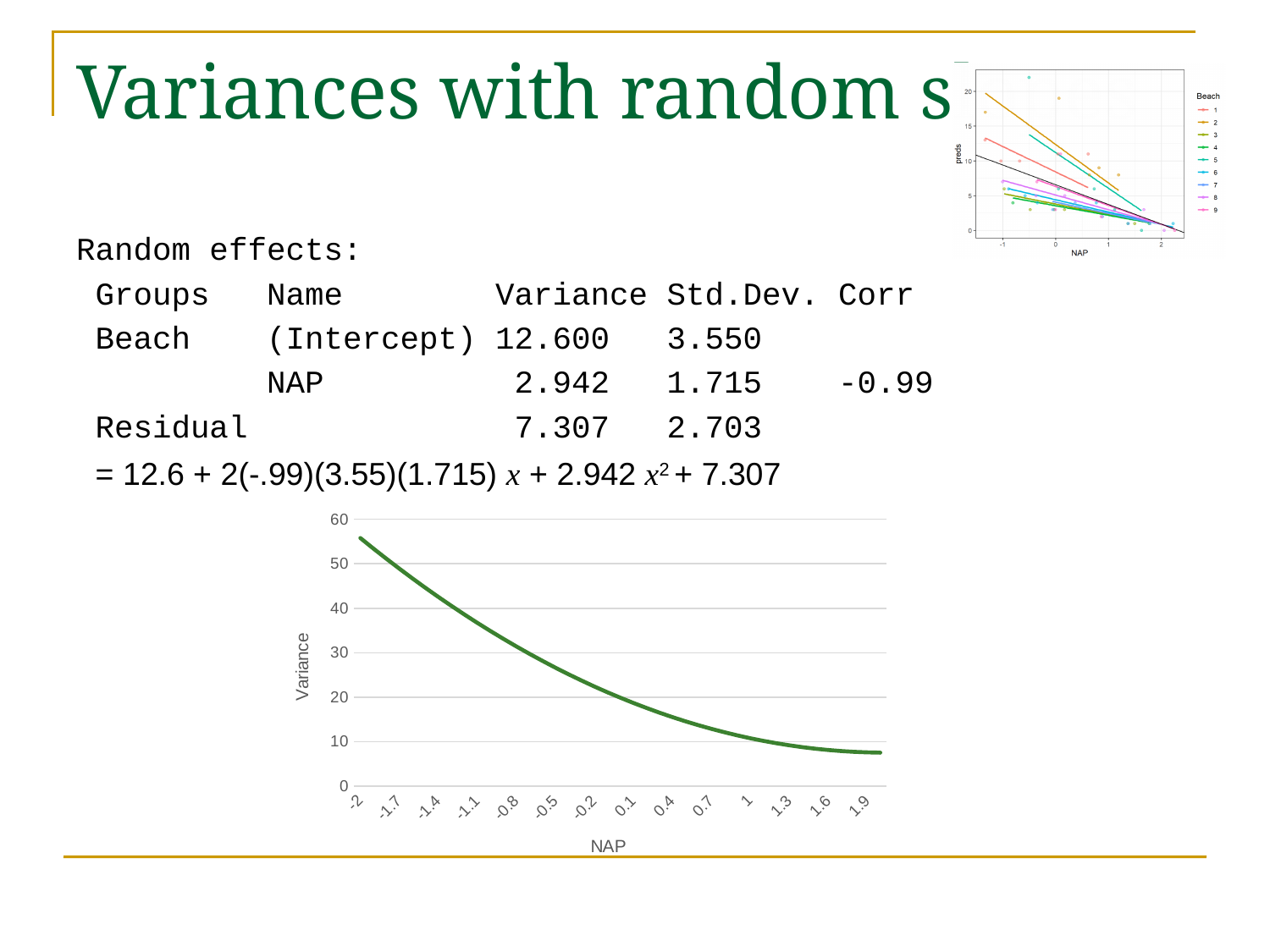
In the bottom chart, which NAP value has the highest Variance? -2 What is the label on the y axis of the top-right chart? preds What kind of chart is the bottom chart with Variance on the y axis? line chart In the top-right chart, how many Beach entries does the legend list? 9 In the bottom chart, is the Variance at NAP = -2 greater or less than 50? greater In the bottom chart, is the Variance at NAP = -1.4 greater or less than 40? greater In the bottom chart, is the Variance at NAP = 1.9 greater or less than 10? less In the bottom chart, how many NAP tick labels are shown on the x axis? 14 In the bottom chart, do the Variance values rise or fall as NAP increases? fall